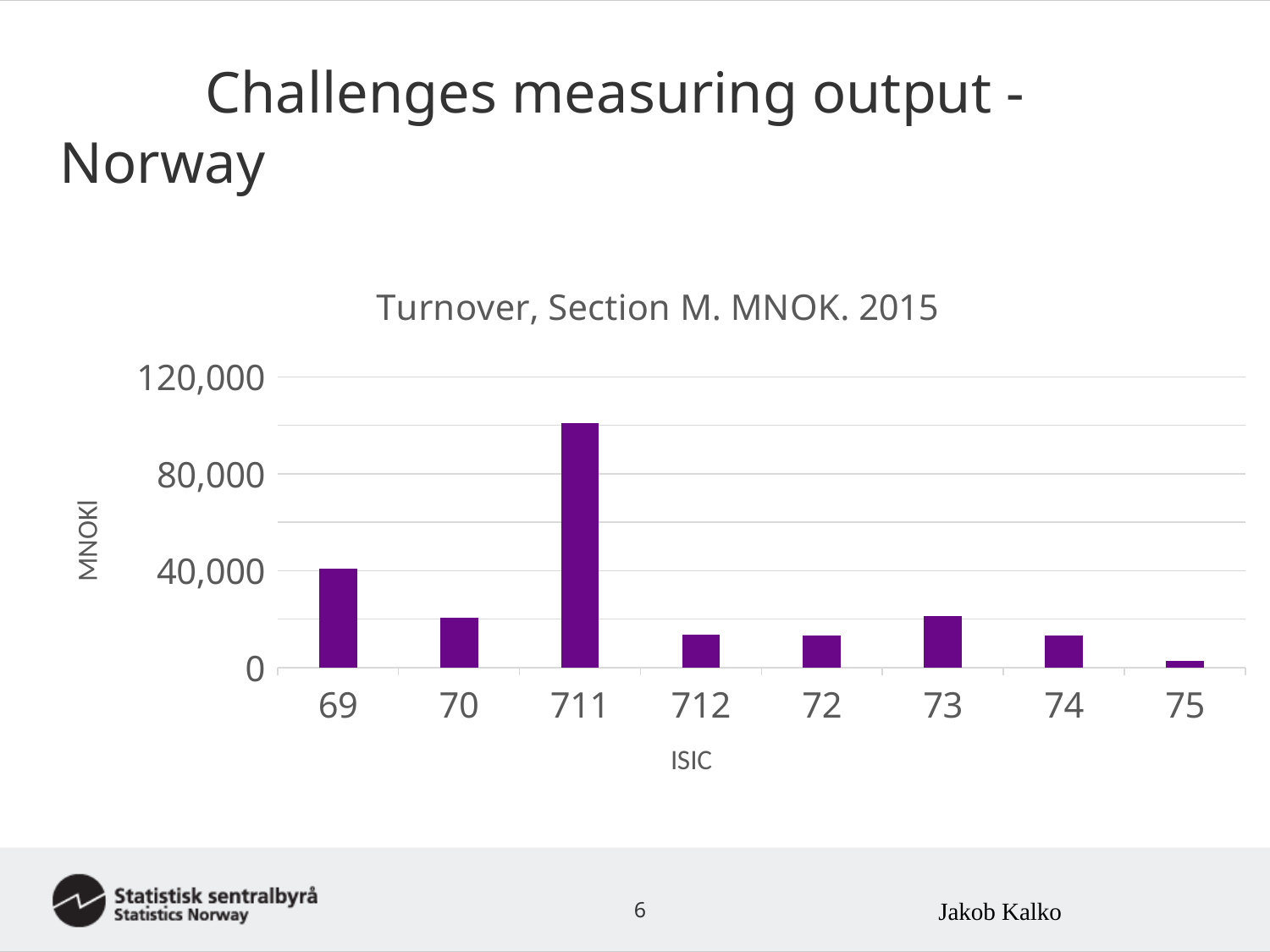
Which ISIC category has the lowest turnover? 75 Is the turnover for ISIC 75 greater or less than 40,000? less Which ISIC category has the highest turnover? 711 Which has a higher turnover, ISIC 69 or ISIC 70? 69 Is the turnover for ISIC 69 greater or less than 80,000? less Is the turnover for ISIC 70 greater or less than 40,000? less Which has a higher turnover, ISIC 73 or ISIC 712? 73 What is the label on the vertical axis of the chart? MNOK What kind of chart is shown on the slide? Bar chart What is the title of the chart? Turnover, Section M. MNOK. 2015 How many ISIC categories are plotted in the chart? 8